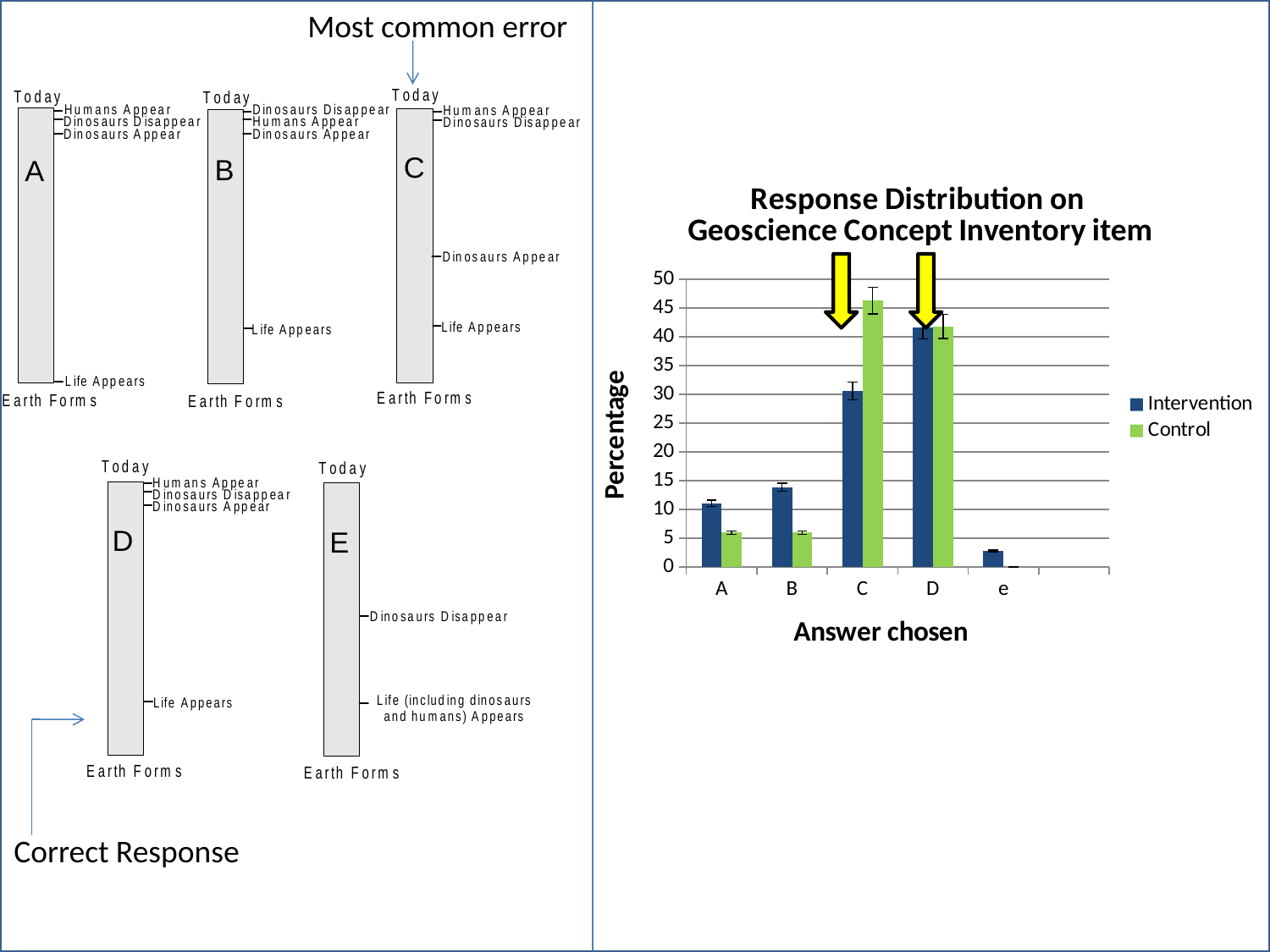
What is the y-axis title of the 'Response Distribution on Geoscience Concept Inventory item' chart? Percentage In the 'Response Distribution on Geoscience Concept Inventory item' chart, which answer has the highest Control percentage? C In the 'Response Distribution on Geoscience Concept Inventory item' chart, which answer has the lowest Intervention percentage? e In the 'Response Distribution on Geoscience Concept Inventory item' chart, for answer A, which series has the larger percentage, Intervention or Control? Intervention In the 'Response Distribution on Geoscience Concept Inventory item' chart, which answer has the highest Intervention percentage? D What kind of chart is shown on the right side of the slide? bar chart In the 'Response Distribution on Geoscience Concept Inventory item' chart, for answer C, which series has the larger percentage, Intervention or Control? Control In the 'Response Distribution on Geoscience Concept Inventory item' chart, is the Control value for answer C greater or less than 40? greater How many series does the legend of the 'Response Distribution on Geoscience Concept Inventory item' chart list? 2 In the 'Response Distribution on Geoscience Concept Inventory item' chart, is the Control value for answer A greater or less than 10? less How many answer categories are shown on the x axis of the 'Response Distribution on Geoscience Concept Inventory item' chart? 5 What are the two legend entries in the 'Response Distribution on Geoscience Concept Inventory item' chart? Intervention and Control